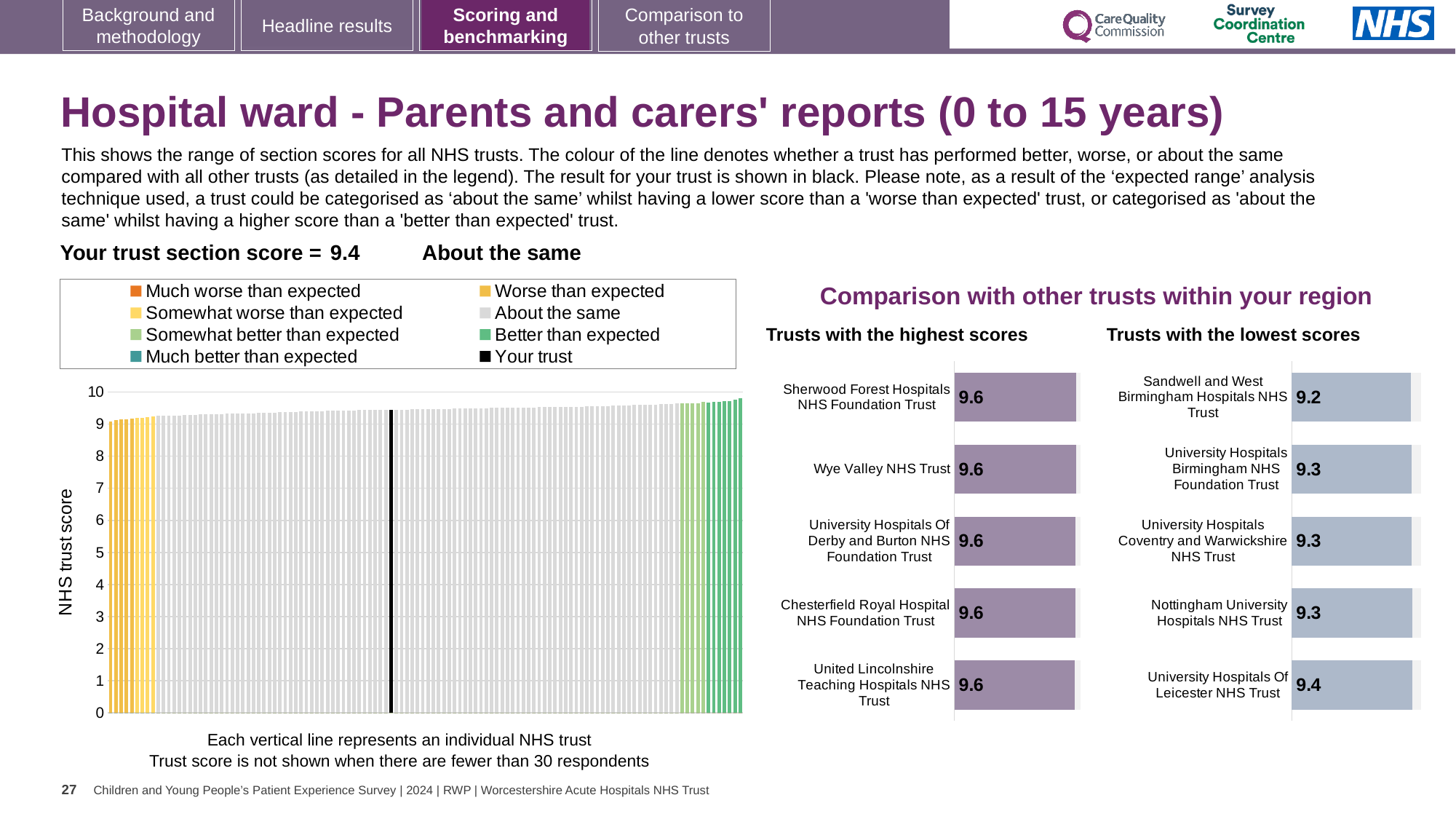
In the 'Trusts with the lowest scores' chart, which trust has the highest score? University Hospitals Of Leicester NHS Trust How many trusts are shown in the 'Trusts with the highest scores' chart? 5 In the 'Trusts with the lowest scores' chart, what is the difference between the scores of University Hospitals Of Leicester NHS Trust and Sandwell and West Birmingham Hospitals NHS Trust? 0.2 What type of chart is the large chart on the left showing NHS trust scores? Bar chart In the 'Trusts with the lowest scores' chart, what is the score for Sandwell and West Birmingham Hospitals NHS Trust? 9.2 How many entries does the legend above the large chart on the left list? 8 In the 'Trusts with the lowest scores' chart, which trust has the lowest score? Sandwell and West Birmingham Hospitals NHS Trust In the large chart on the left, is the value for your trust (the black line) greater or less than 9? greater In the 'Trusts with the highest scores' chart, what is the score for Wye Valley NHS Trust? 9.6 What is the y-axis label of the large chart on the left? NHS trust score In the 'Trusts with the lowest scores' chart, which has the larger score: University Hospitals Of Leicester NHS Trust or Sandwell and West Birmingham Hospitals NHS Trust? University Hospitals Of Leicester NHS Trust In the 'Trusts with the lowest scores' chart, what is the score for Nottingham University Hospitals NHS Trust? 9.3